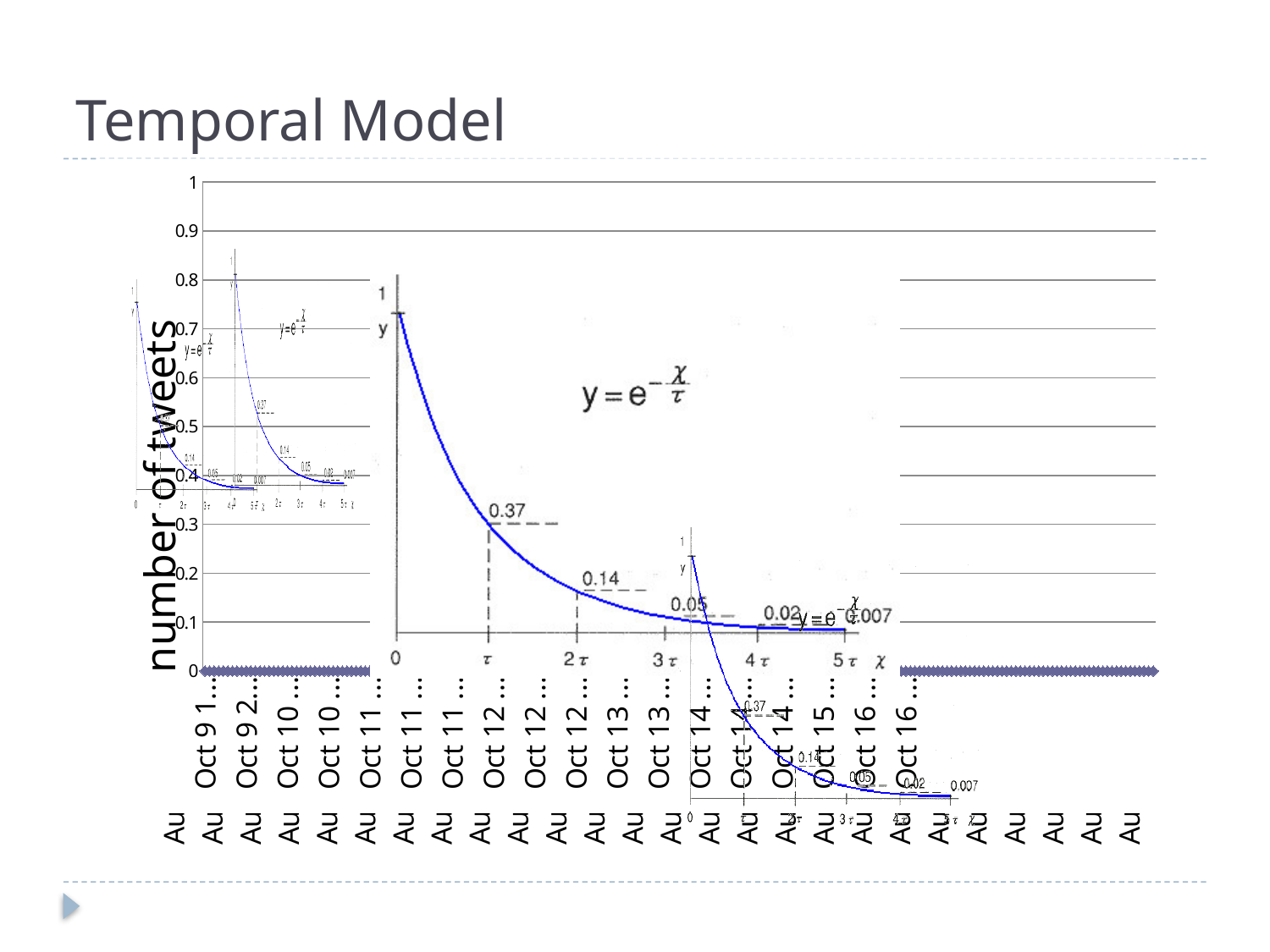
In the large overlaid exponential decay plot, which labelled point has the lowest value? 5τ In the large overlaid exponential decay plot, do the values rise or fall as x increases? fall In the large overlaid exponential decay plot, what value is labelled at x = 4τ? 0.02 In the large overlaid exponential decay plot, what value is labelled at x = 2τ? 0.14 What is the label on the vertical axis of the chart? number of tweets In the large overlaid exponential decay plot, how many labelled values are marked along the curve (excluding the starting value of 1)? 5 What is the highest value shown on the chart's vertical axis? 1 In the large overlaid exponential decay plot, which is larger: the value at τ or the value at 3τ? the value at τ In the large overlaid exponential decay plot, what value is labelled at x = 3τ? 0.05 In the large overlaid exponential decay plot, what is the difference between the values labelled at τ and at 2τ? 0.23 In the large overlaid exponential decay plot, what value is labelled at x = 5τ? 0.007 In the large overlaid exponential decay plot, what value is labelled at x = τ? 0.37